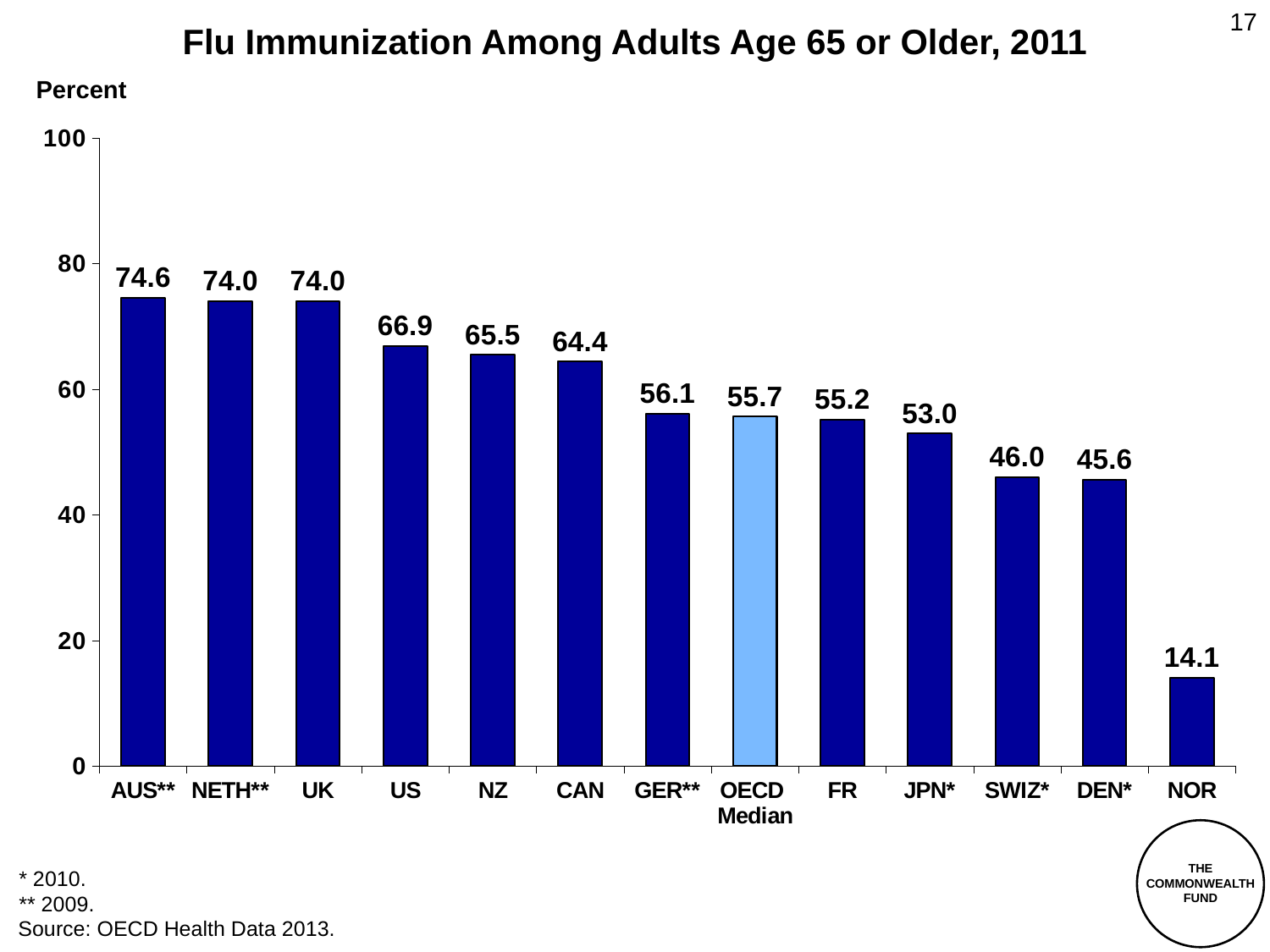
How many bars are shown in the chart? 13 What is the title of the chart? Flu Immunization Among Adults Age 65 or Older, 2011 Which has a higher value, CAN or FR? CAN Which country has the lowest flu immunization rate? NOR Which country has the highest flu immunization rate? AUS** What type of chart is shown on the slide? bar chart What is the value shown for the OECD Median? 55.7 What is the value for NOR? 14.1 What is the difference between the US value and the OECD Median? 11.2 What is the difference between the values for AUS** and NOR? 60.5 What is the flu immunization rate for the US? 66.9 Is the value for JPN* greater or less than 60? less